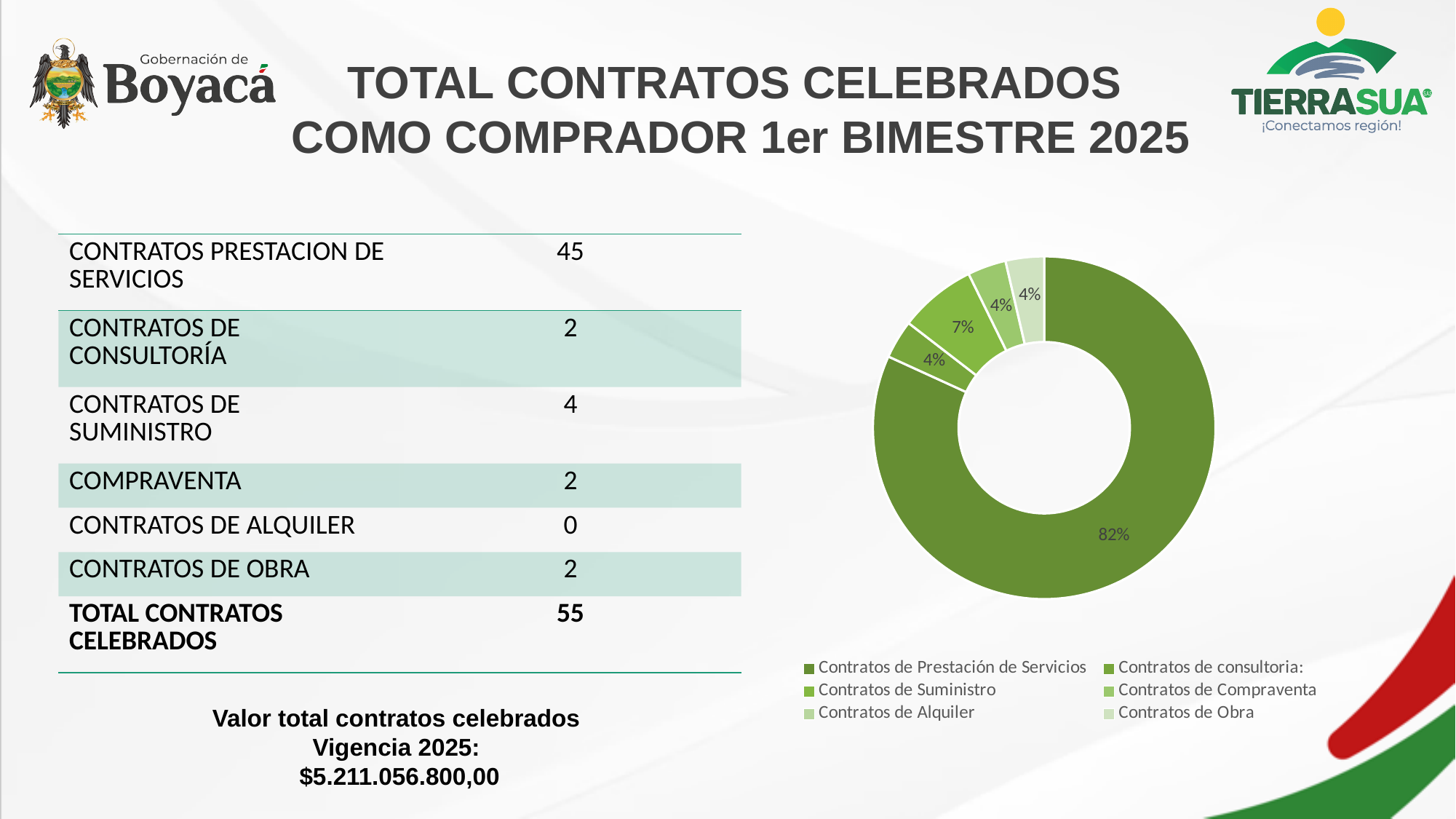
What is the difference in percentage points between the Contratos de Prestación de Servicios slice and the Contratos de Suministro slice? 75% What kind of chart is shown on the slide? Pie chart (donut) What share of the chart does Contratos de Suministro represent? 7% Which category has the largest slice in the chart? Contratos de Prestación de Servicios What is the title of the slide containing the chart? TOTAL CONTRATOS CELEBRADOS COMO COMPRADOR 1er BIMESTRE 2025 How many entries does the chart legend list? 6 Which is larger, the Contratos de Prestación de Servicios slice or the Contratos de consultoria slice? Contratos de Prestación de Servicios What percentage is shown for the Contratos de Obra slice? 4% Which is larger in the chart, the slice for Contratos de Suministro or the slice for Contratos de Compraventa? Contratos de Suministro What share of the chart does Contratos de Prestación de Servicios represent? 82% Which legend entry is shown with the darkest green colour? Contratos de Prestación de Servicios